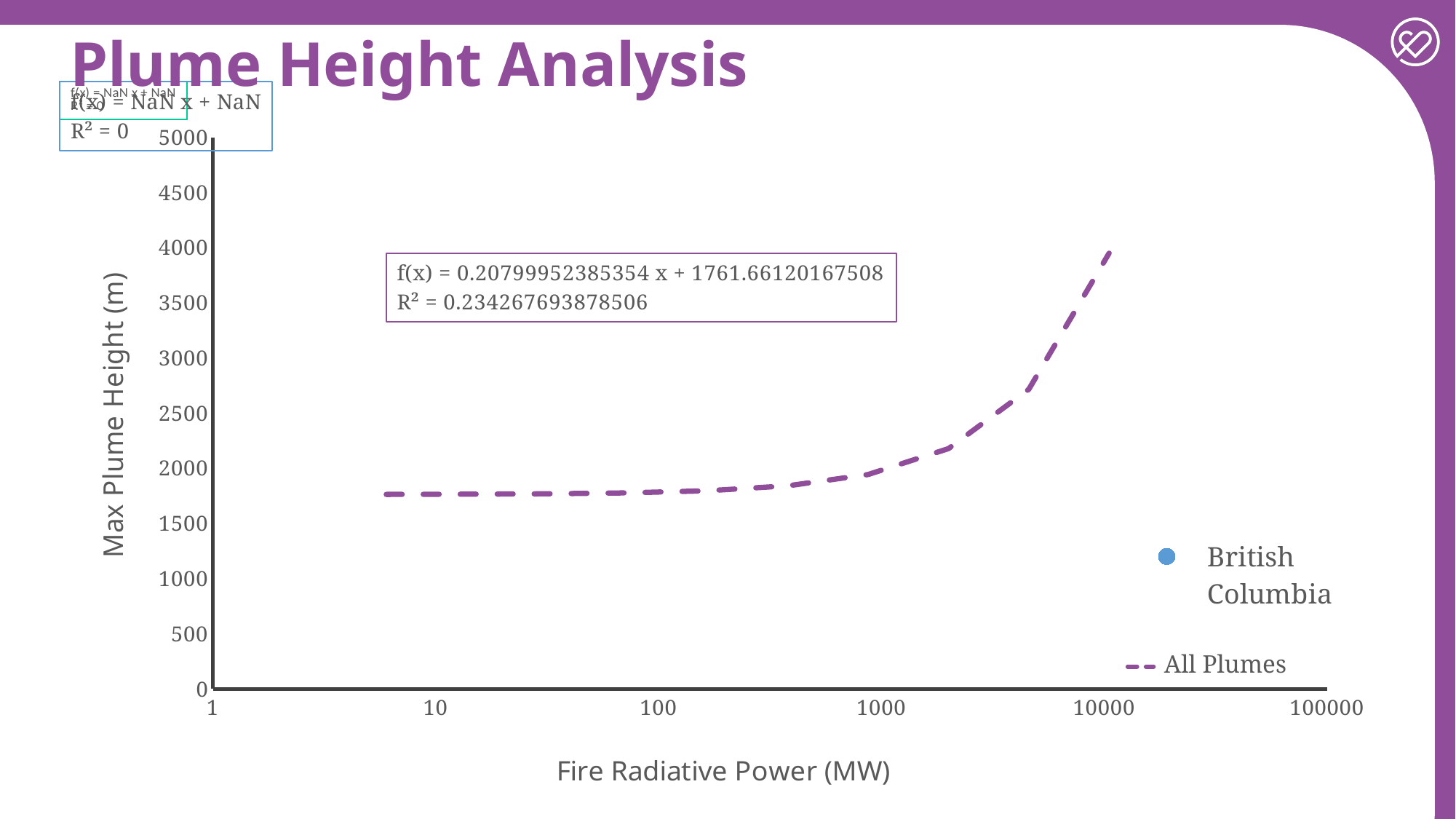
How many entries does the chart legend list? 2 What is the label of the y axis? Max Plume Height (m) Is the All Plumes trendline value at 10 MW greater or less than 1500? greater What kind of chart is shown on the slide? scatter chart with a trendline Is the All Plumes trendline value at 10 MW greater or less than 2000? less Is the All Plumes trendline value at 10000 MW greater or less than 3000? greater What is the label of the x axis? Fire Radiative Power (MW) What R² value is printed in the trendline equation box in the middle of the chart? 0.234267693878506 What are the two entries listed in the chart legend? British Columbia and All Plumes Does the All Plumes trendline rise or fall as Fire Radiative Power increases? rise What is the title of the chart on the slide? Plume Height Analysis What is the maximum value shown on the y axis? 5000